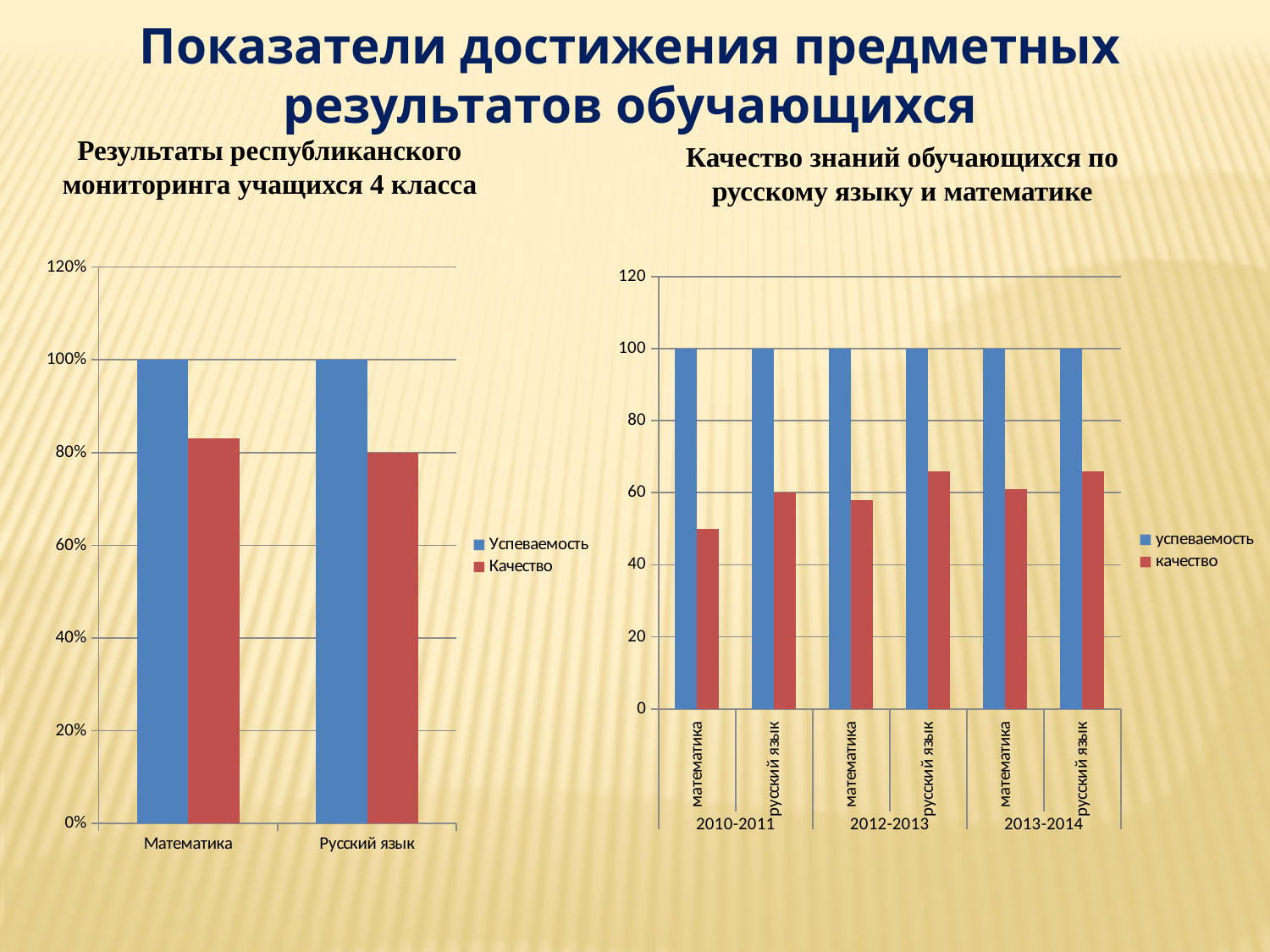
In the left chart (Результаты республиканского мониторинга учащихся 4 класса), what is the Успеваемость value for Математика? 100% In the right chart (Качество знаний обучающихся по русскому языку и математике), does the качество value for математика rise or fall from 2010-2011 to 2013-2014? rises In the left chart (Результаты республиканского мониторинга учащихся 4 класса), how many series does the legend list? 2 In the right chart (Качество знаний обучающихся по русскому языку и математике), is the качество value for математика in 2010-2011 greater or less than 60? less In the right chart (Качество знаний обучающихся по русскому языку и математике), how many series does the legend list? 2 In the right chart (Качество знаний обучающихся по русскому языку и математике), what is the успеваемость value for математика in 2010-2011? 100 In the right chart (Качество знаний обучающихся по русскому языку и математике), which bar has the lowest качество value? математика, 2010-2011 What type of chart is the left chart titled "Результаты республиканского мониторинга учащихся 4 класса"? bar chart In the left chart (Результаты республиканского мониторинга учащихся 4 класса), how many categories are shown on the x axis? 2 In the right chart (Качество знаний обучающихся по русскому языку и математике), how many school-year groups are shown on the x axis? 3 In the left chart (Результаты республиканского мониторинга учащихся 4 класса), which category has the higher Качество value, Математика or Русский язык? Математика In the left chart (Результаты республиканского мониторинга учащихся 4 класса), is the Качество value for Математика greater or less than 80%? greater